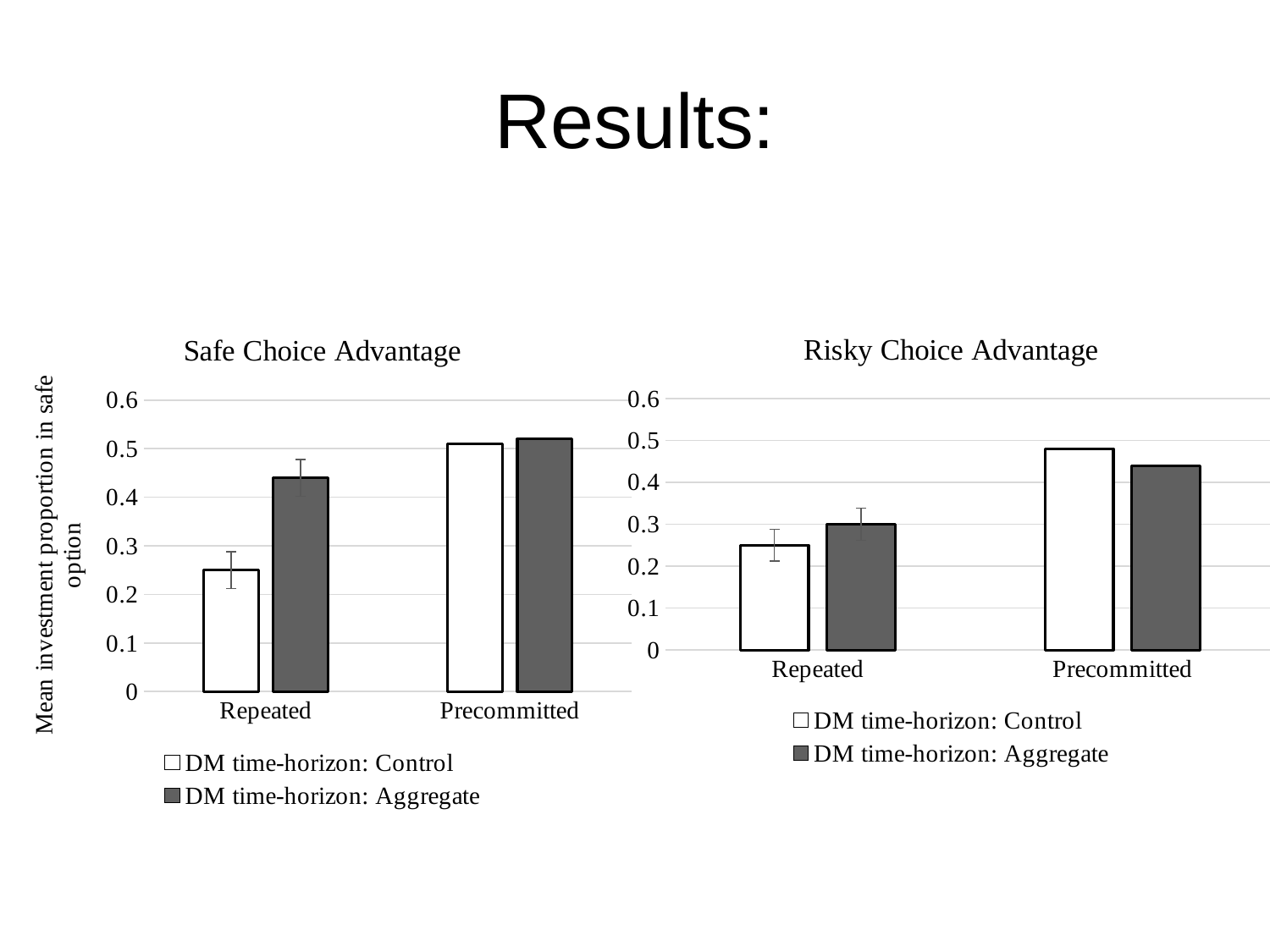
What is the y-axis label of the Safe Choice Advantage chart? Mean investment proportion in safe option How many categories are shown on the x axis of the Safe Choice Advantage chart? 2 In the Safe Choice Advantage chart, is the value for DM time-horizon: Control in the Repeated condition greater or less than 0.3? less In the Safe Choice Advantage chart, is the value for DM time-horizon: Aggregate in the Repeated condition greater or less than 0.4? greater What type of chart is the Safe Choice Advantage chart? bar chart In the Risky Choice Advantage chart, which series has the larger value in the Precommitted condition? DM time-horizon: Control How many series does the legend of the Risky Choice Advantage chart list? 2 In the Risky Choice Advantage chart, is the value for DM time-horizon: Control in the Precommitted condition greater or less than 0.4? greater In the Safe Choice Advantage chart, does the DM time-horizon: Control series rise or fall from Repeated to Precommitted? rise In the Safe Choice Advantage chart, which bar is the lowest? DM time-horizon: Control, Repeated In the Safe Choice Advantage chart, which series has the larger value in the Repeated condition? DM time-horizon: Aggregate